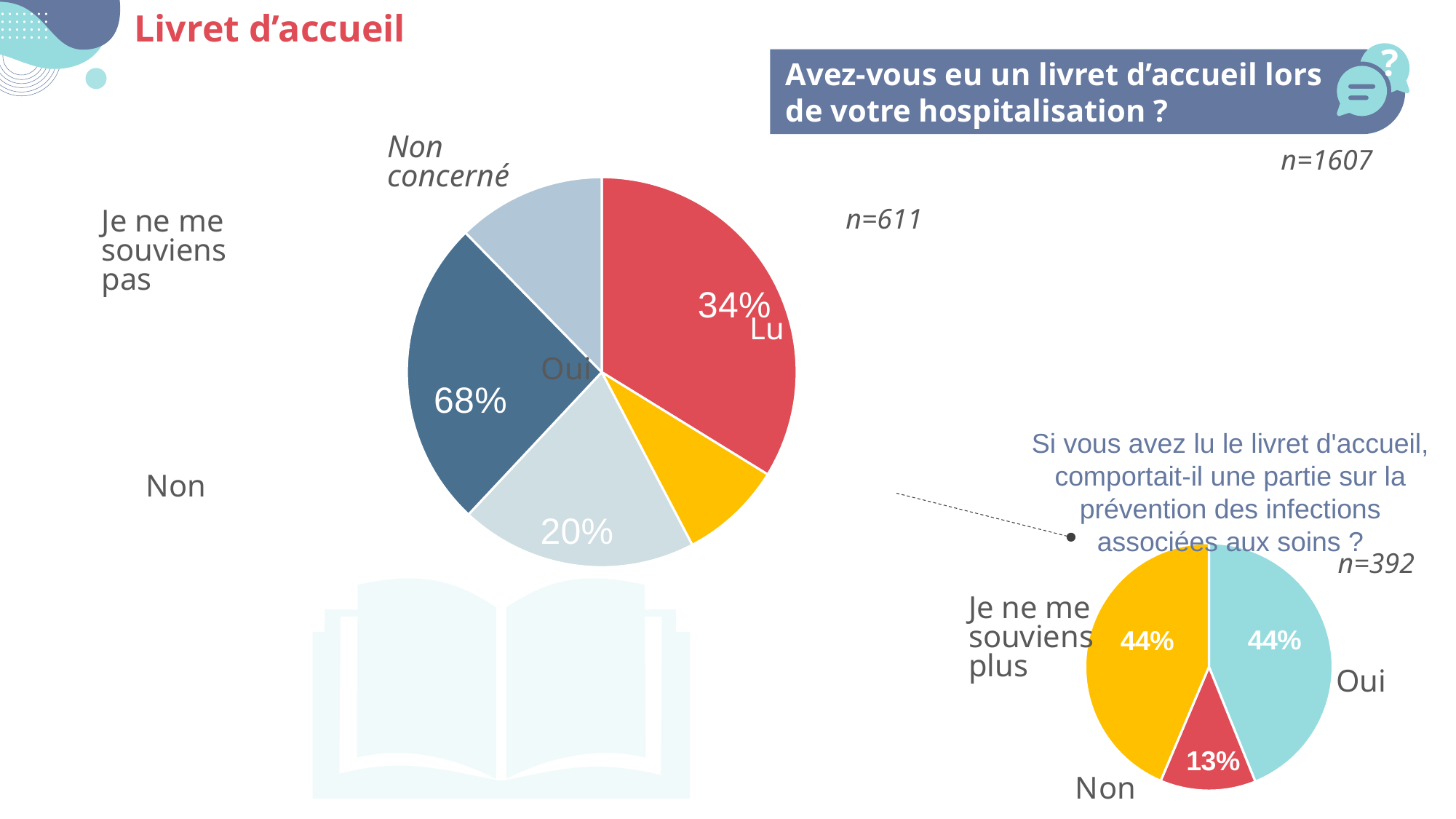
What kind of chart is the small chart at the bottom right of the slide? Pie chart In the small pie chart at the bottom right (n=392), what is the difference in percentage points between 'Oui' and 'Non'? 31% In the small pie chart at the bottom right (n=392), what percentage is shown for 'Oui'? 44% In the small pie chart at the bottom right (n=392), which is larger, the share for 'Oui' or the share for 'Non'? Oui How many slices does the small pie chart at the bottom right (n=392) have? 3 In the small pie chart at the bottom right (n=392), what percentage is shown for 'Je ne me souviens plus'? 44% In the small pie chart at the bottom right (n=392), what percentage is shown for 'Non'? 13% In the large pie chart in the centre of the slide, what percentage is shown for 'Lu'? 34% In the small pie chart at the bottom right (n=392), which category has the smallest share? Non In the large pie chart in the centre of the slide, what is the largest percentage printed on a slice? 68% What sample size (n) is printed next to the small pie chart at the bottom right? n=392 What kind of chart is the large chart in the centre of the slide? Pie chart